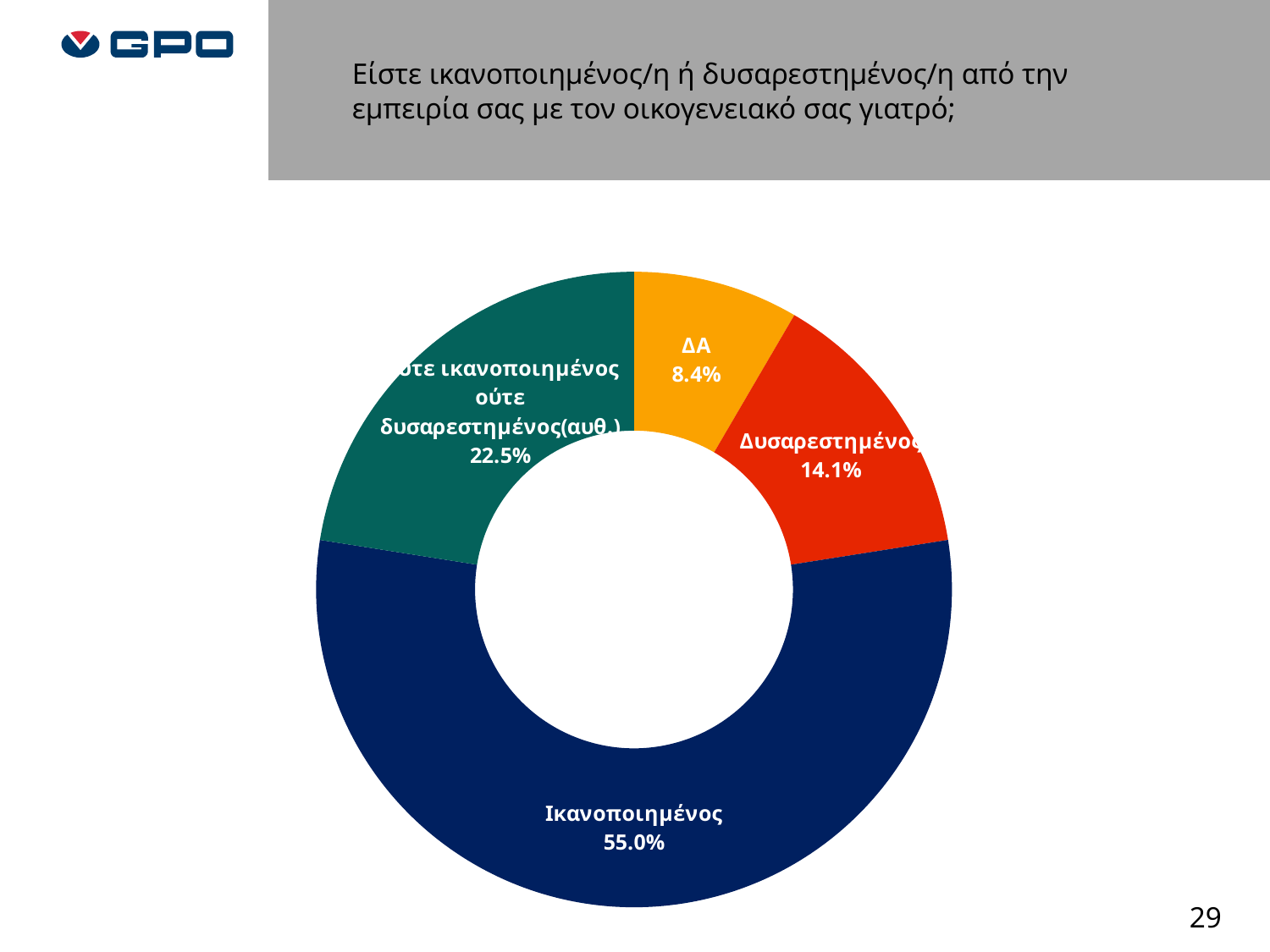
What type of chart is shown on the slide? Doughnut chart Which category has the largest share of the chart? Ικανοποιημένος What percentage is shown for ΔΑ? 8.4% What is the difference in percentage points between the 'ούτε ικανοποιημένος ούτε δυσαρεστημένος(αυθ.)' slice and ΔΑ? 14.1 What colour is the Ικανοποιημένος slice? Dark blue How many slices does the chart have? 4 What percentage of respondents answered Ικανοποιημένος? 55.0% What is the difference in percentage points between Ικανοποιημένος and Δυσαρεστημένος? 40.9 What percentage is shown for the 'ούτε ικανοποιημένος ούτε δυσαρεστημένος(αυθ.)' slice? 22.5% Which is larger, the share for Δυσαρεστημένος or the share for ΔΑ? Δυσαρεστημένος What percentage of respondents answered Δυσαρεστημένος? 14.1% Which category has the smallest share of the chart? ΔΑ